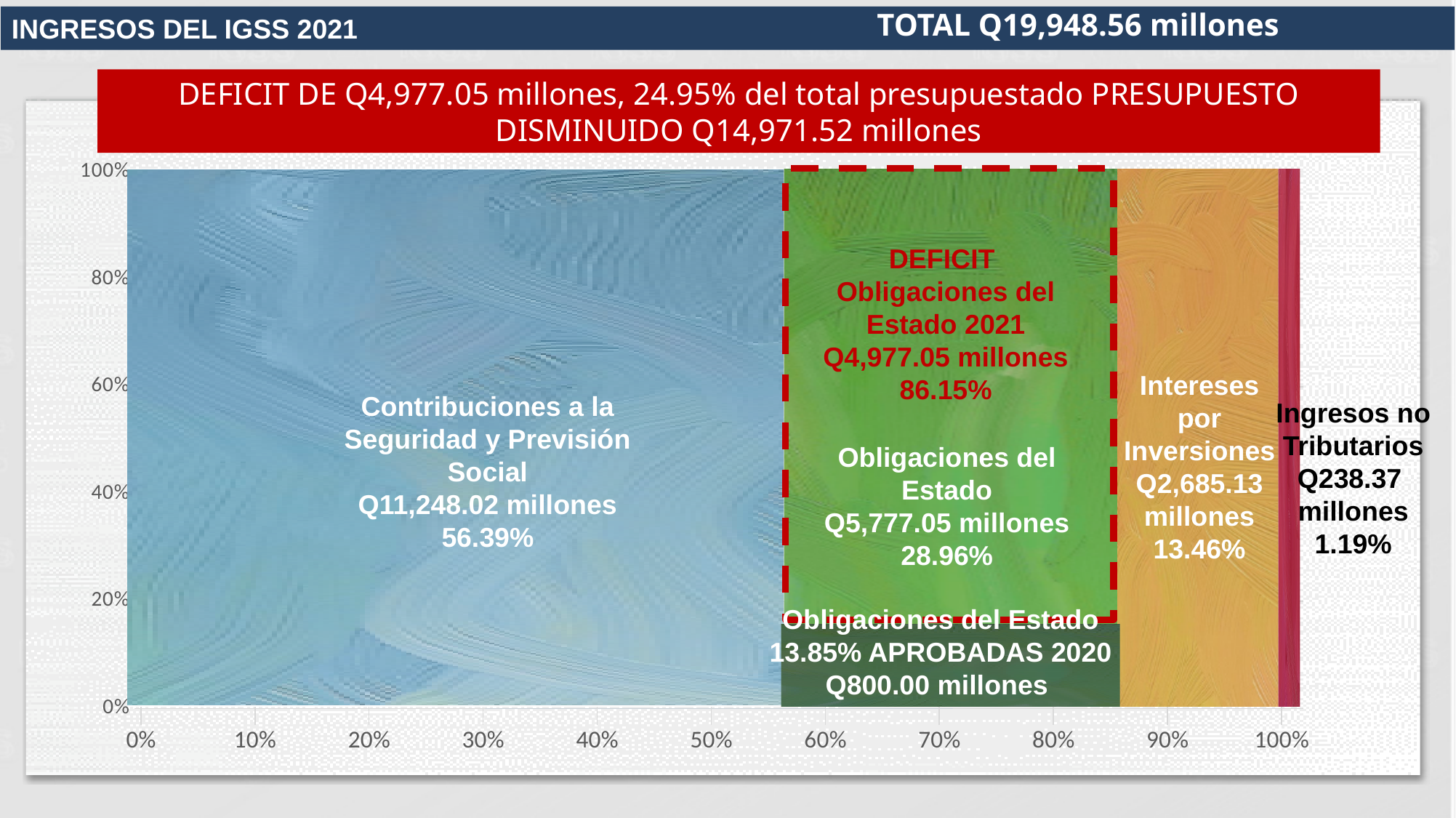
Which segment of the bar has the largest share? Contribuciones a la Seguridad y Previsión Social Which segment of the bar has the smallest share? Ingresos no Tributarios What percentage share is shown for Obligaciones del Estado? 28.96% What is the value shown for Intereses por Inversiones? Q2,685.13 millones What kind of chart is shown on the slide? Stacked bar chart How many segments make up the stacked bar? 4 What is the title of the chart? INGRESOS DEL IGSS 2021 Which is larger, the value for Intereses por Inversiones or the value for Ingresos no Tributarios? Intereses por Inversiones What is the difference in percentage points between the share of Contribuciones a la Seguridad y Previsión Social and the share of Obligaciones del Estado? 27.43 What is the value shown for Contribuciones a la Seguridad y Previsión Social? Q11,248.02 millones What percentage share is shown for Ingresos no Tributarios? 1.19% What total is shown for the ingresos del IGSS 2021? Q19,948.56 millones